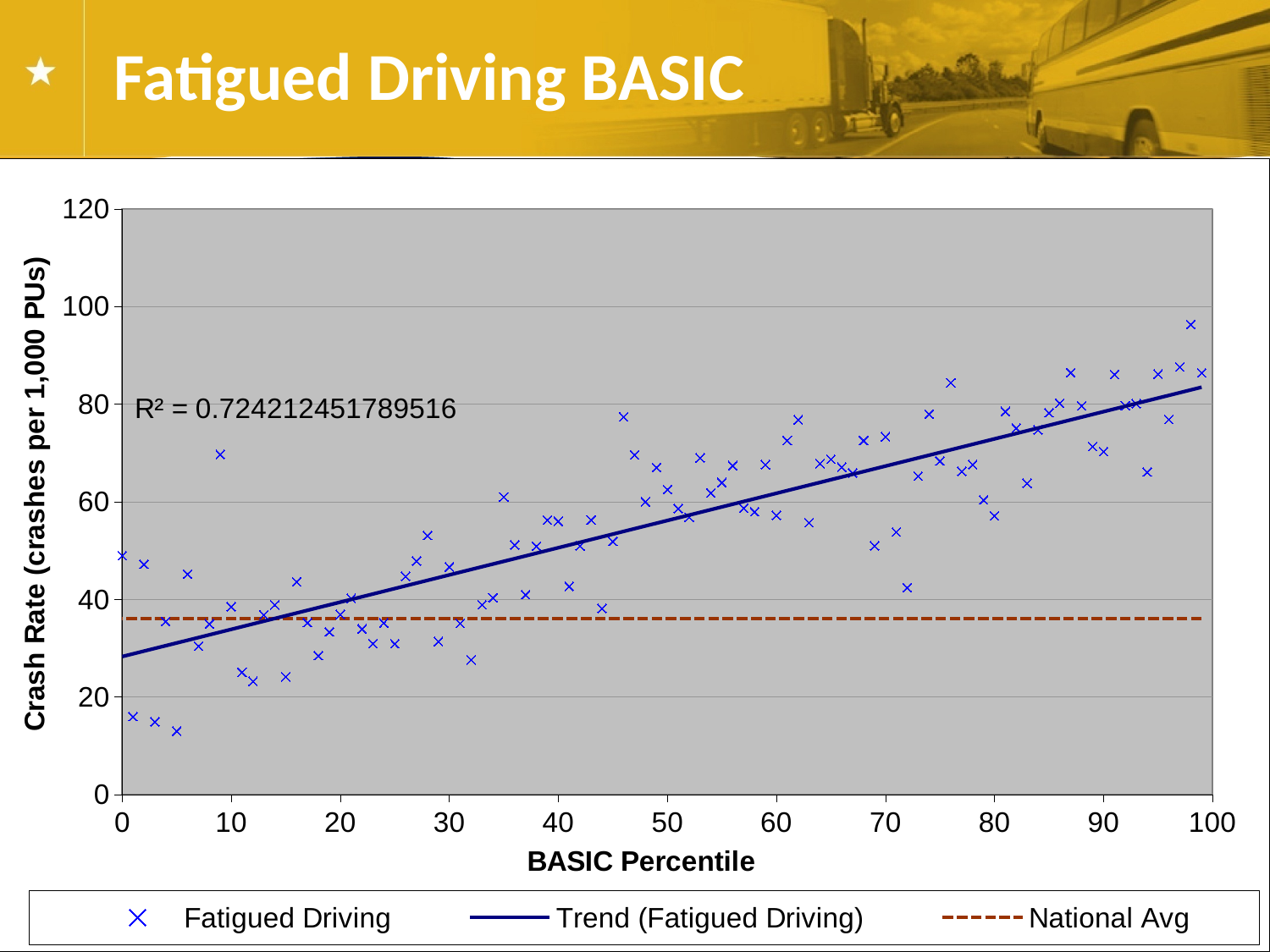
How many series does the legend list? 3 Is the trend line value at BASIC Percentile 0 greater or less than 40? less Is the National Avg line greater or less than 40 crashes per 1,000 PUs? less What is the R² value printed on the chart? R² = 0.724212451789516 Is the highest Fatigued Driving data point greater or less than 90 crashes per 1,000 PUs? greater What is the title of the y axis? Crash Rate (crashes per 1,000 PUs) What kind of chart is shown on the slide? scatter chart Does the trend line for Fatigued Driving rise or fall as the BASIC Percentile increases? rise What is the title of the x axis? BASIC Percentile